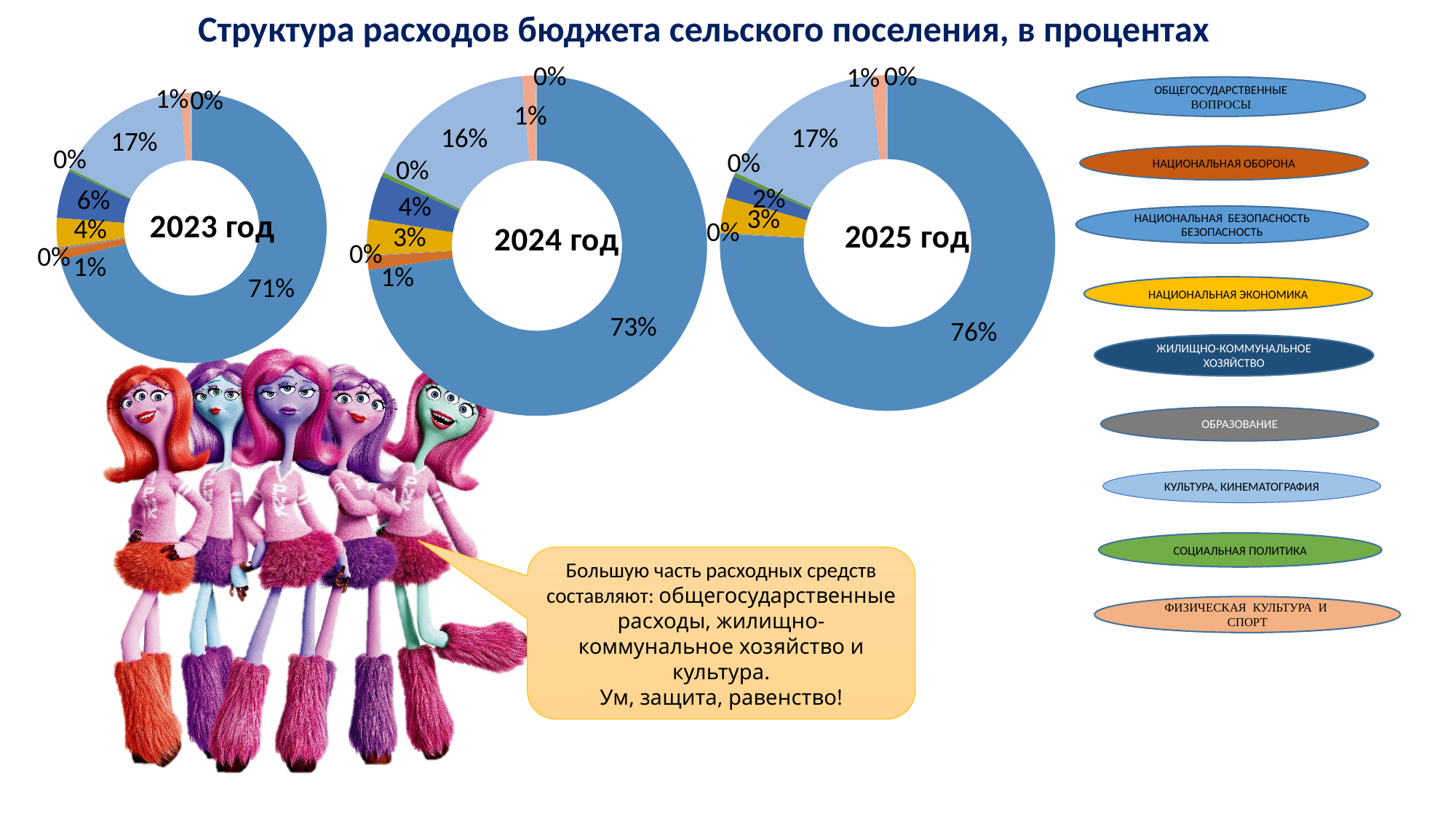
How does the share of Общегосударственные вопросы change from 2023 to 2025 across the three charts? It rises (71%, 73%, 76%) In the 2024 год chart, what share is shown for Культура, кинематография (light blue slice)? 16% How many categories does the legend on the right list? 9 In the 2025 год chart, what share is shown for Жилищно-коммунальное хозяйство (dark blue slice)? 2% In the 2023 год chart, what share is shown for the largest slice (Общегосударственные вопросы)? 71% In the 2024 год chart, what share is shown for Общегосударственные вопросы? 73% In the 2023 год chart, what share is shown for Жилищно-коммунальное хозяйство (dark blue slice)? 6% What type of chart is used on this slide? Pie (donut) chart Which category has the largest share in the 2025 год chart? Общегосударственные вопросы What is the difference between the Общегосударственные вопросы share in 2025 год and in 2023 год? 5 percentage points In the 2025 год chart, what share is shown for Общегосударственные вопросы? 76% In the 2023 год chart, what share is shown for Национальная экономика (yellow slice)? 4%